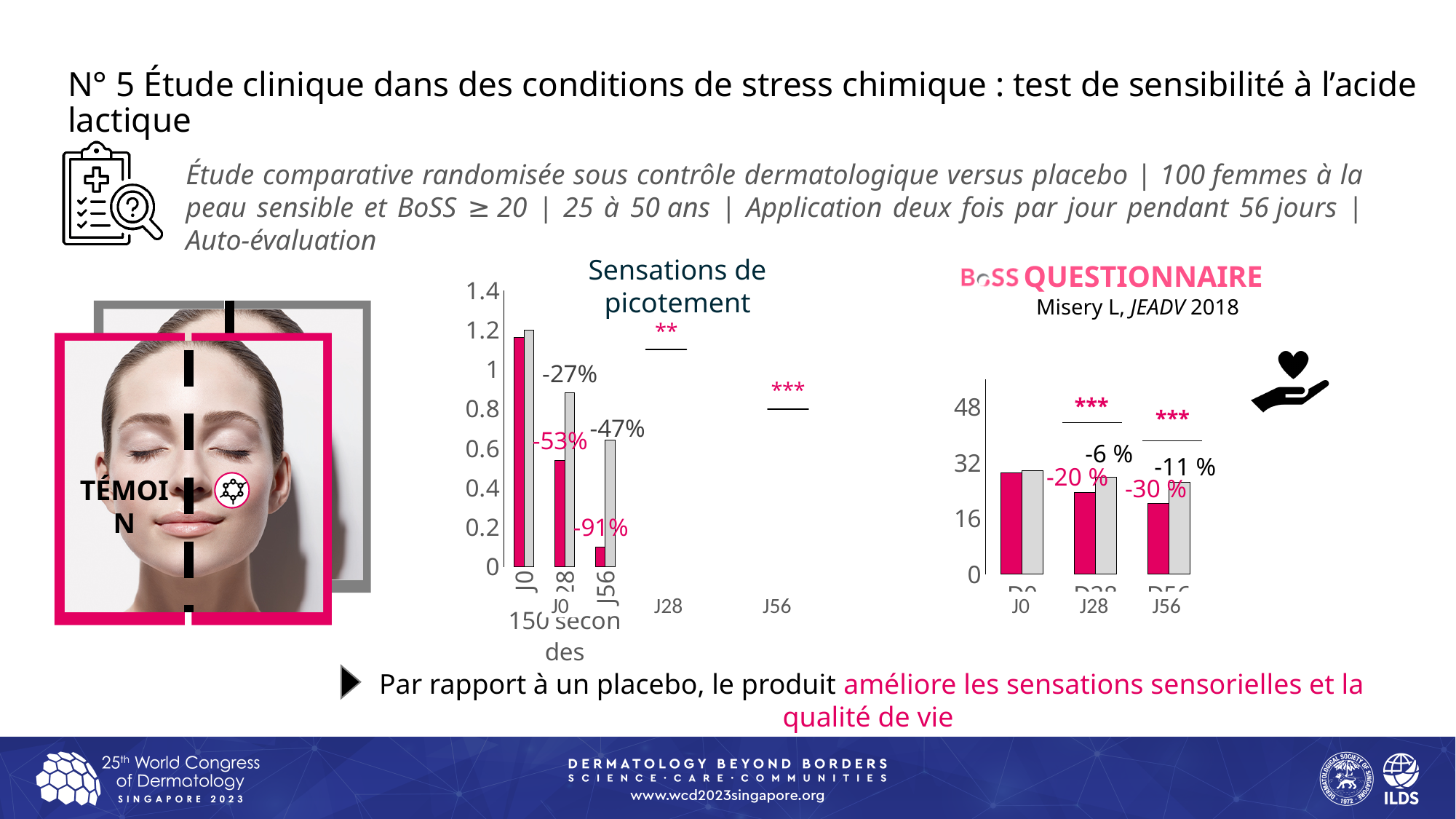
In the "BoSS QUESTIONNAIRE" chart, what percentage change is labelled on the grey bar at J28? -6 % In the "Sensations de picotement" chart, is the grey bar at J28 greater or less than 0.8? greater In the "Sensations de picotement" chart, what percentage change is labelled on the grey bar at J56? -47% In the "Sensations de picotement" chart, what percentage change is labelled on the pink bar at J56? -91% How many time points are shown on the x axis of the "Sensations de picotement" chart? 3 In the "Sensations de picotement" chart, what percentage change is labelled on the pink bar at J28? -53% In the "BoSS QUESTIONNAIRE" chart, what percentage change is labelled on the pink bar at J56? -30 % In the "Sensations de picotement" chart, is the pink bar at J56 greater or less than 0.2? less In the "BoSS QUESTIONNAIRE" chart, is the pink bar at J56 greater or less than 32? less In the "BoSS QUESTIONNAIRE" chart, at J56, which bar is taller, the pink bar or the grey bar? the grey bar What kind of chart is the "Sensations de picotement" chart? bar chart In the "Sensations de picotement" chart, do the pink bars rise or fall from J0 to J56? fall